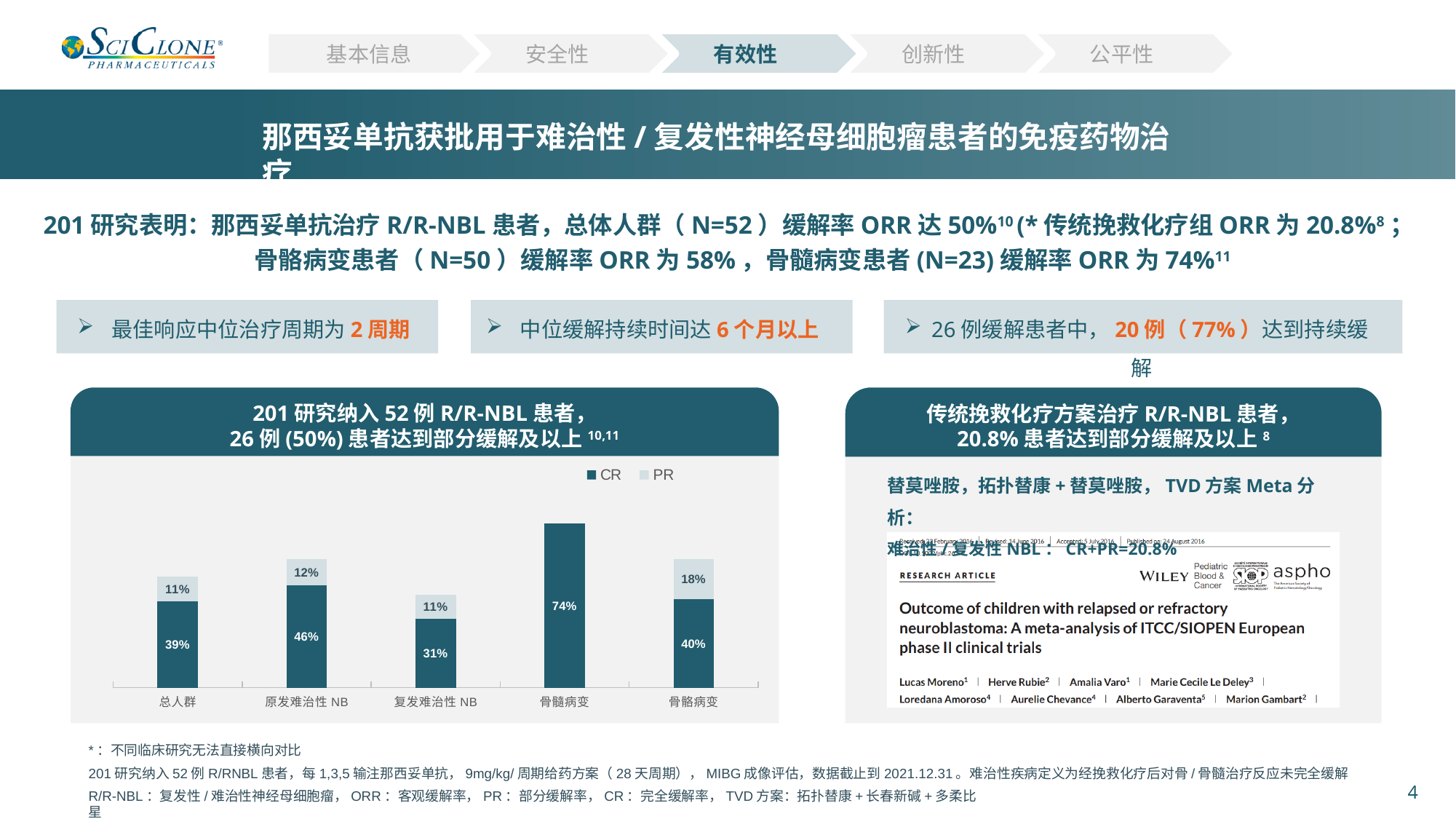
What is the PR value for 骨骼病变? 18% What is the total (CR plus PR) of the stacked bar for 原发难治性 NB? 58% How many categories are shown on the x axis of the chart? 5 Which category has the lowest CR value? 复发难治性 NB What are the two series named in the chart legend? CR and PR Which is larger, the CR value for 骨骼病变 or the CR value for 总人群? 骨骼病变 What is the CR value for 总人群? 39% Which category has the highest CR value? 骨髓病变 How many series does the chart legend list? 2 What type of chart is shown on the slide? stacked bar chart What is the CR value for 骨髓病变? 74% What is the difference between the CR values for 原发难治性 NB and 复发难治性 NB? 15%